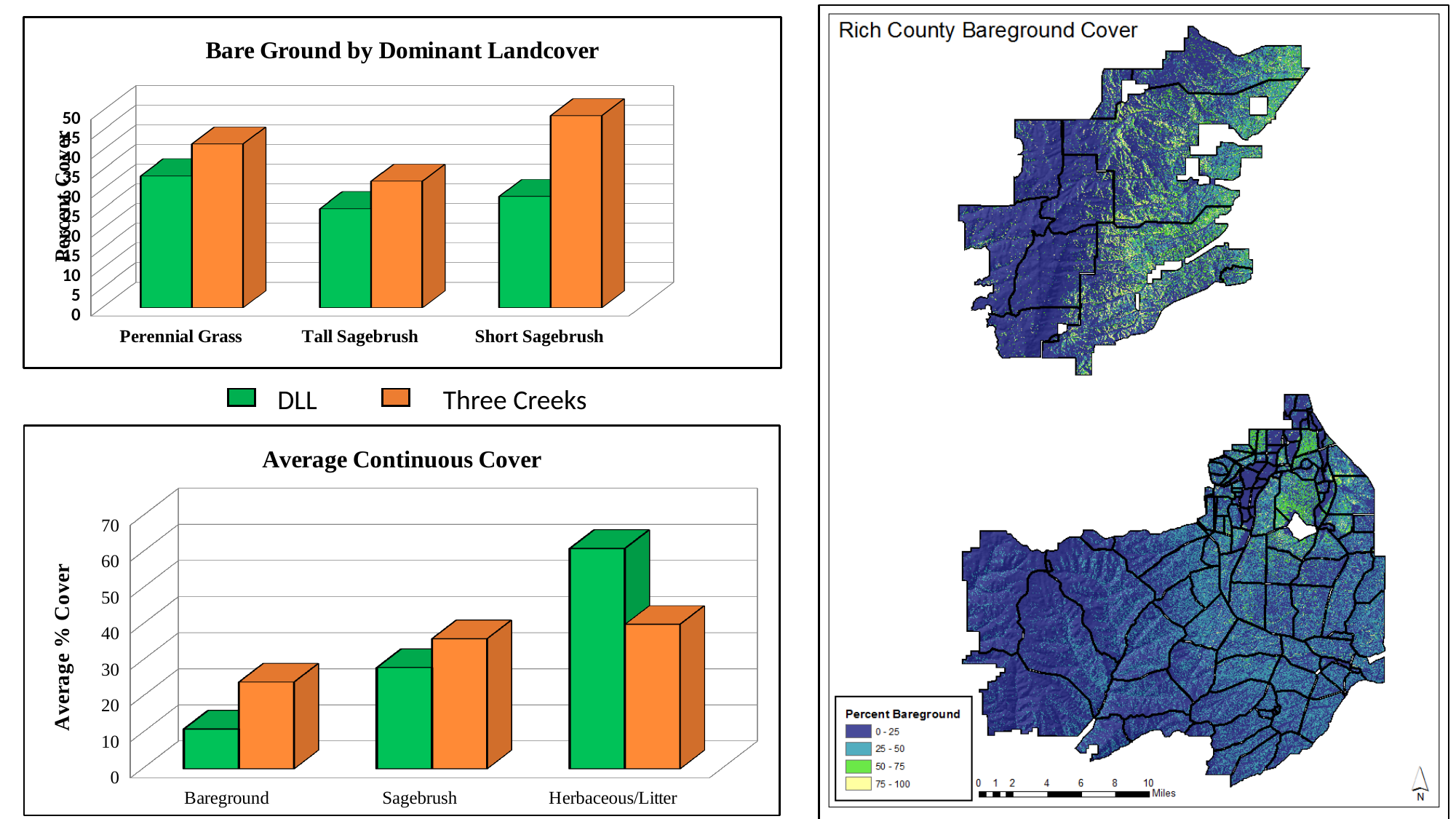
In the "Average Continuous Cover" chart, which category has the highest DLL value? Herbaceous/Litter In the "Bare Ground by Dominant Landcover" chart, which category has the highest DLL value? Perennial Grass In the "Average Continuous Cover" chart, which category has the lowest Three Creeks value? Bareground In the "Average Continuous Cover" chart, do the DLL values rise or fall from Bareground to Herbaceous/Litter? rise In the "Average Continuous Cover" chart, is the DLL value for Bareground greater or less than 20? less How many landcover categories are shown on the x axis of the "Bare Ground by Dominant Landcover" chart? 3 In the "Bare Ground by Dominant Landcover" chart, is the Three Creeks value for Short Sagebrush greater or less than 40? greater In the "Average Continuous Cover" chart, for Herbaceous/Litter, which series has the larger value, DLL or Three Creeks? DLL In the "Bare Ground by Dominant Landcover" chart, which category has the highest Three Creeks value? Short Sagebrush How many series does the legend between the two charts list? 2 What kind of chart is the "Bare Ground by Dominant Landcover" chart? bar chart In the "Bare Ground by Dominant Landcover" chart, for Perennial Grass, which series has the larger value, DLL or Three Creeks? Three Creeks